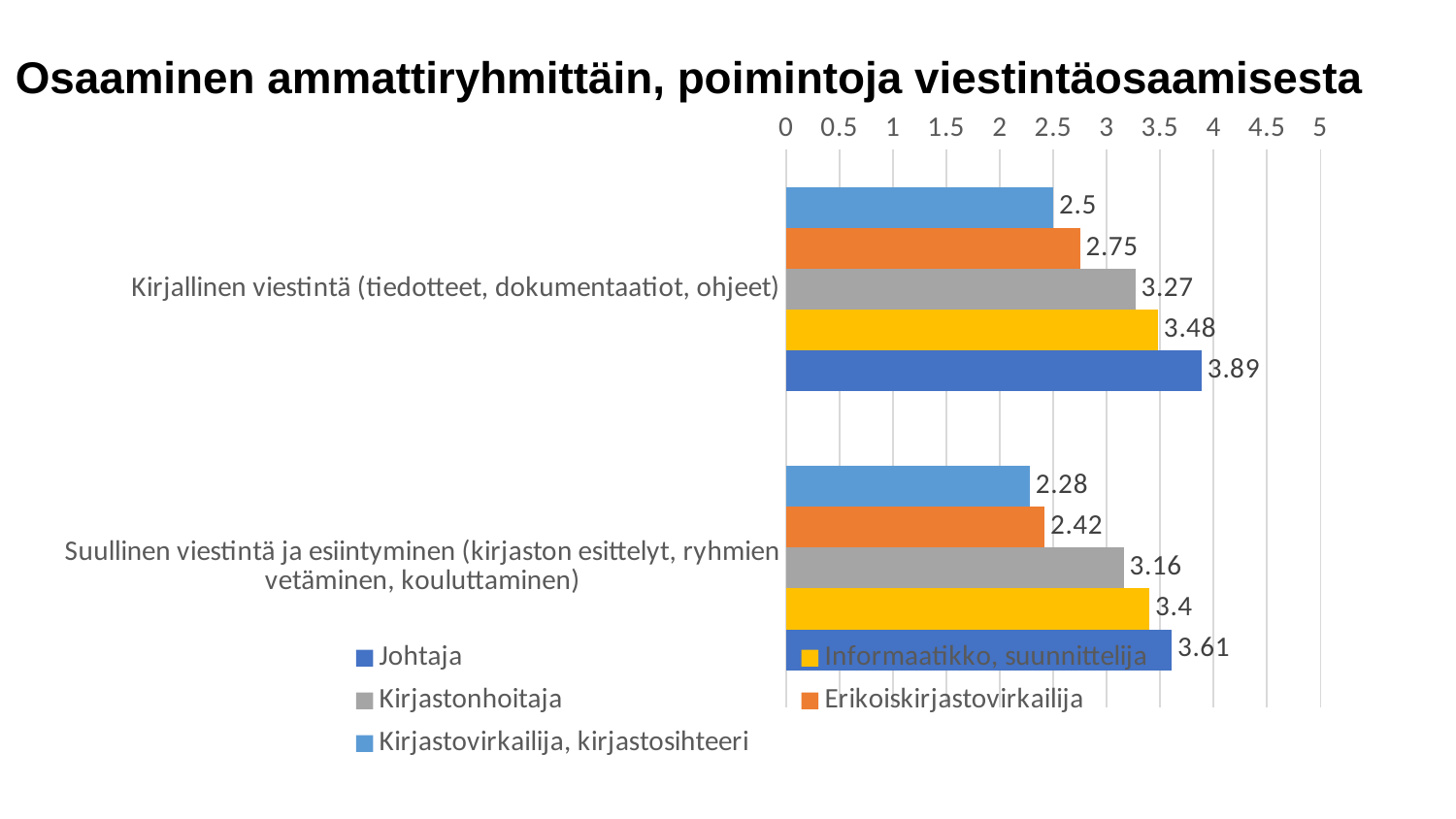
Which is larger for Suullinen viestintä ja esiintyminen: the value for Kirjastonhoitaja or the value for Erikoiskirjastovirkailija? Kirjastonhoitaja Which professional group has the lowest value for Kirjallinen viestintä? Kirjastovirkailija, kirjastosihteeri What is the value for Kirjastonhoitaja in the category Kirjallinen viestintä? 3.27 How many categories are shown on the chart? 2 What kind of chart is shown on the slide? Bar chart Is the value for Informaatikko, suunnittelija in Suullinen viestintä ja esiintyminen greater or less than 3? greater What is the value for Johtaja in the category Kirjallinen viestintä (tiedotteet, dokumentaatiot, ohjeet)? 3.89 Which professional group has the highest value for Suullinen viestintä ja esiintyminen? Johtaja What is the value for Erikoiskirjastovirkailija in the category Suullinen viestintä ja esiintyminen? 2.42 What is the difference between the Johtaja value and the Informaatikko, suunnittelija value for Kirjallinen viestintä? 0.41 How many series does the legend list? 5 What is the value for Kirjastovirkailija, kirjastosihteeri in the category Suullinen viestintä ja esiintyminen? 2.28